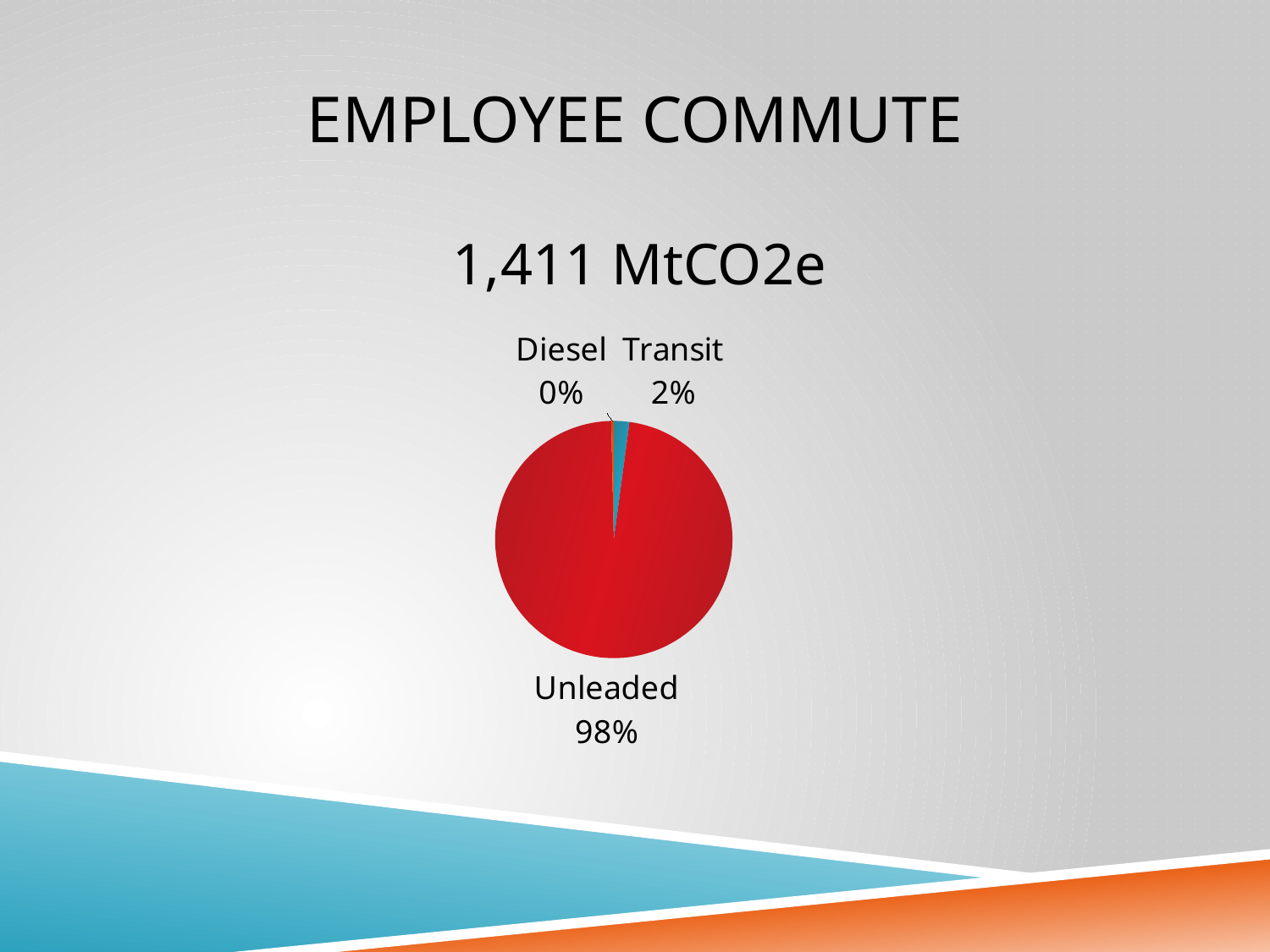
Which category has the largest slice of the pie? Unleaded What share of the pie does Transit account for? 2% What share of the pie does Unleaded account for? 98% Which is larger, the share for Transit or the share for Diesel? Transit Which category has the smallest slice of the pie? Diesel What is the difference in percentage points between Unleaded and Transit? 96 What kind of chart is shown on the slide? pie chart How many categories are shown in the pie chart? 3 What colour is the Unleaded slice? red What percentage is shown for Diesel? 0%